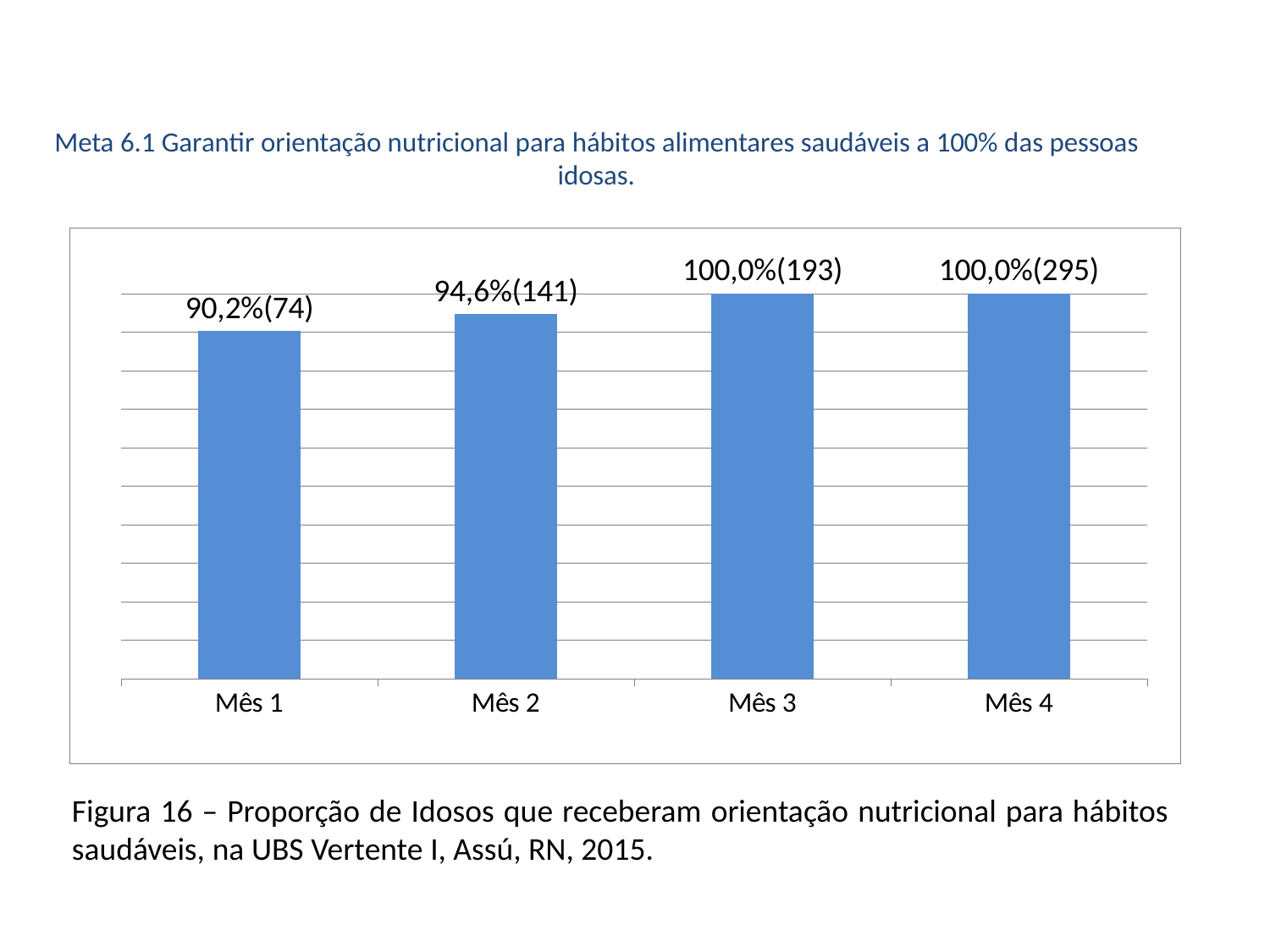
Which month has the lowest percentage? Mês 1 Do the percentages rise or fall from Mês 1 to Mês 4? Rise What is the difference in percentage points between Mês 2 and Mês 1? 4,4 Which is larger, the percentage for Mês 1 or for Mês 2? Mês 2 What is the data label shown for Mês 2? 94,6%(141) What is the data label shown for Mês 4? 100,0%(295) What kind of chart is shown on the slide? Bar chart What is the data label shown for Mês 1? 90,2%(74) What percentage is shown for Mês 2? 94,6% What is the data label shown for Mês 3? 100,0%(193) Which months reach 100,0%? Mês 3 and Mês 4 How many months (categories) are shown on the x axis? 4